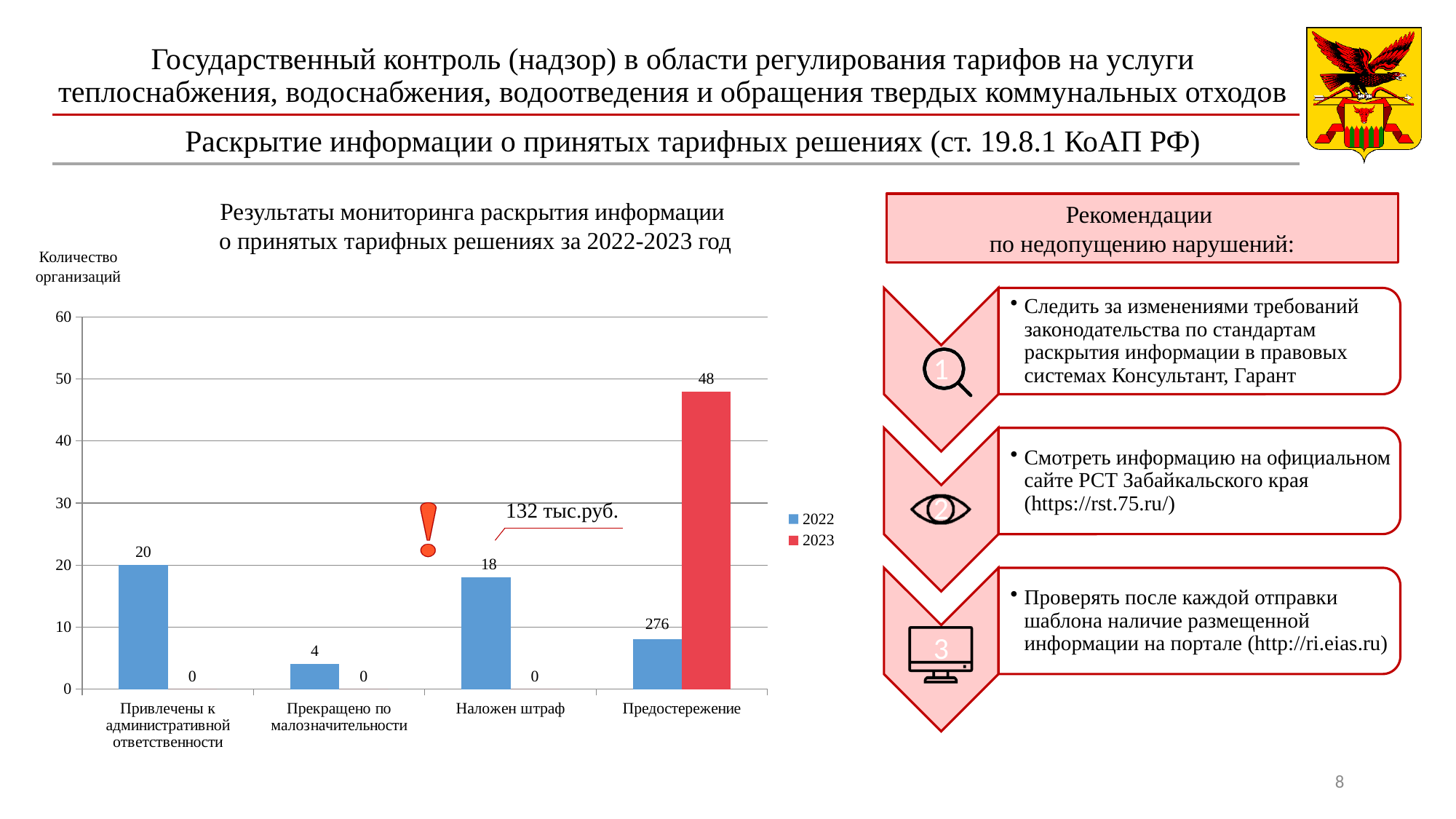
Which is larger in 2022: «Привлечены к административной ответственности» or «Прекращено по малозначительности»? Привлечены к административной ответственности What is the difference between the 2022 values for «Привлечены к административной ответственности» and «Наложен штраф»? 2 How many categories are shown on the x axis of the chart? 4 What is the 2023 value for «Наложен штраф»? 0 Which category has the highest 2023 value? Предостережение How many series does the chart legend list? 2 What is the 2022 value for «Наложен штраф»? 18 What is the 2022 value for «Привлечены к административной ответственности»? 20 What is the 2023 value for «Предостережение»? 48 What kind of chart is shown on the slide? bar chart What is the 2022 value for «Прекращено по малозначительности»? 4 Is the 2023 value for «Предостережение» greater or less than 40? greater